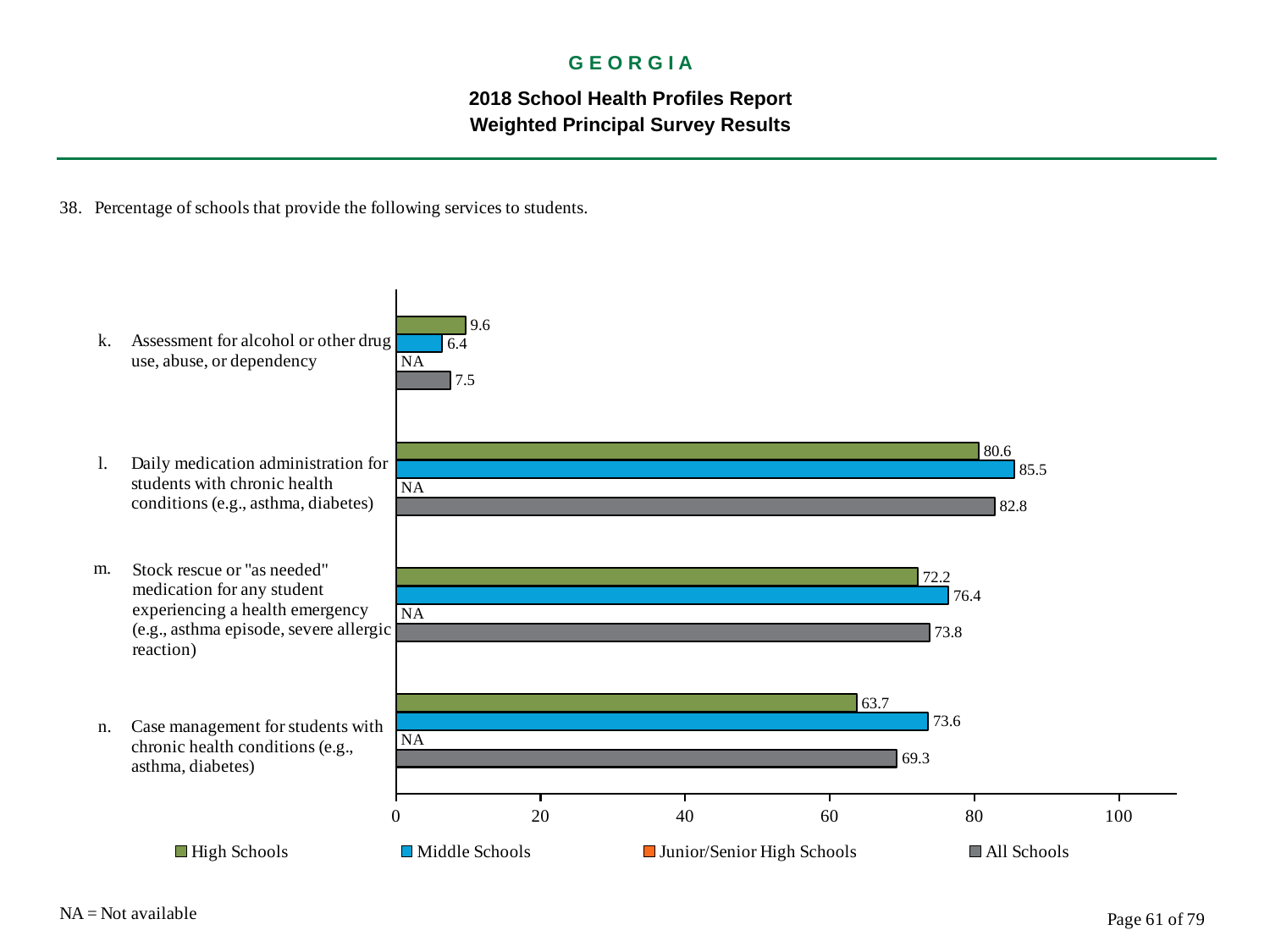
What kind of chart is shown on the slide? Bar chart Is the All Schools value for stock rescue or "as needed" medication greater or less than 60? greater Which service has the highest All Schools value? Daily medication administration for students with chronic health conditions How many services (categories) are shown on the chart? 4 For stock rescue or "as needed" medication, which is larger: the High Schools value or the Middle Schools value? Middle Schools What is the All Schools value for case management for students with chronic health conditions? 69.3 What is the value for Middle Schools for daily medication administration for students with chronic health conditions? 85.5 Which service has the lowest Middle Schools value? Assessment for alcohol or other drug use, abuse, or dependency What is the value for High Schools for assessment for alcohol or other drug use, abuse, or dependency? 9.6 What is the value for Junior/Senior High Schools for stock rescue or "as needed" medication for any student experiencing a health emergency? NA How many series does the legend list? 4 What is the difference between the Middle Schools and High Schools values for case management for students with chronic health conditions? 9.9